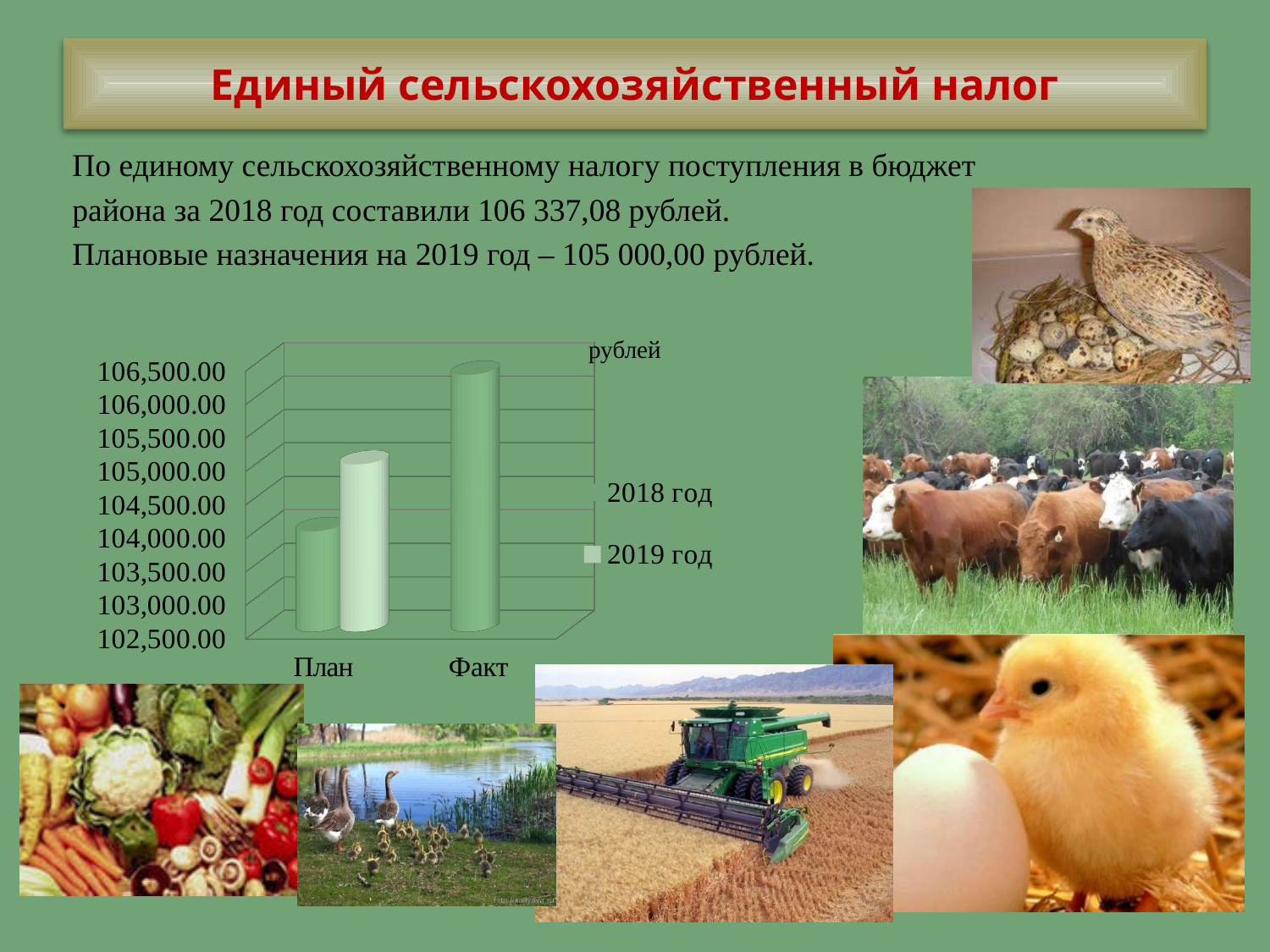
Which bar in the chart is the lowest? План, 2018 год What are the two categories on the x axis of the chart? План, Факт Is the value for План in 2019 год greater or less than 104,500.00? greater Is the value for План in 2018 год greater or less than 104,500.00? less How many series does the chart legend list? 2 For План, which year has the larger value: 2018 год or 2019 год? 2019 год What entries does the chart legend list? 2018 год, 2019 год Is the value for Факт in 2018 год greater or less than 106,000.00? greater For 2018 год, which is larger: План or Факт? Факт Which bar in the chart is the tallest? Факт, 2018 год How many categories are shown on the x axis of the chart? 2 What kind of chart is shown on the slide? bar chart